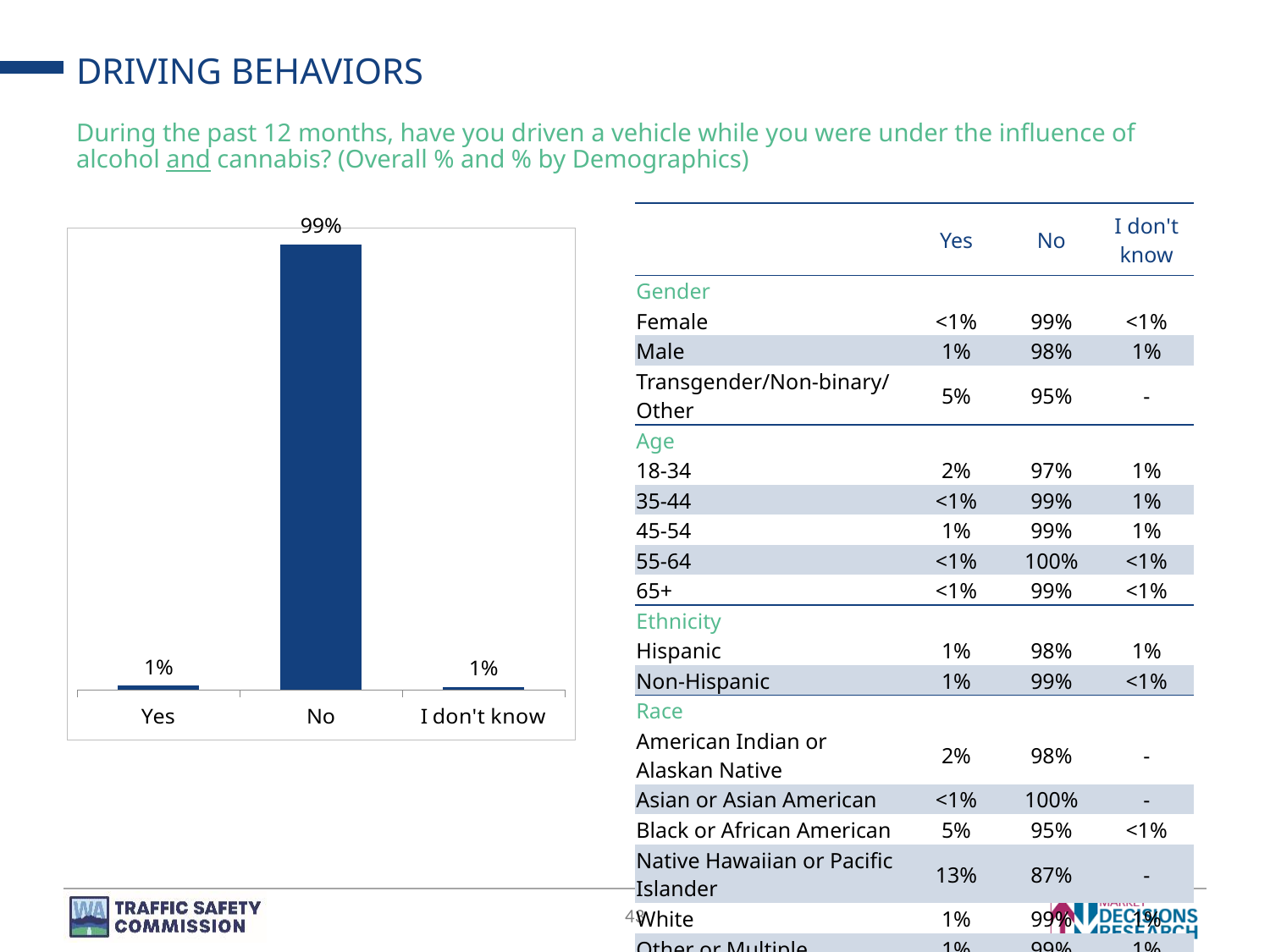
How many categories are shown in the bar chart? 3 What is the value for "I don't know" in the bar chart? 1% Which is larger in the bar chart, the value for "I don't know" or the value for "No"? No Which is larger in the bar chart, the value for "No" or the value for "Yes"? No What colour are the bars in the bar chart? Dark blue What is the difference between the values for "No" and "Yes" in the bar chart? 98 percentage points Which category has the highest value in the bar chart? No What is the value for "No" in the bar chart? 99% What are the category labels on the x axis of the bar chart, from left to right? Yes, No, I don't know What is the value for "Yes" in the bar chart? 1% What kind of chart is shown on the left of the slide? Bar chart